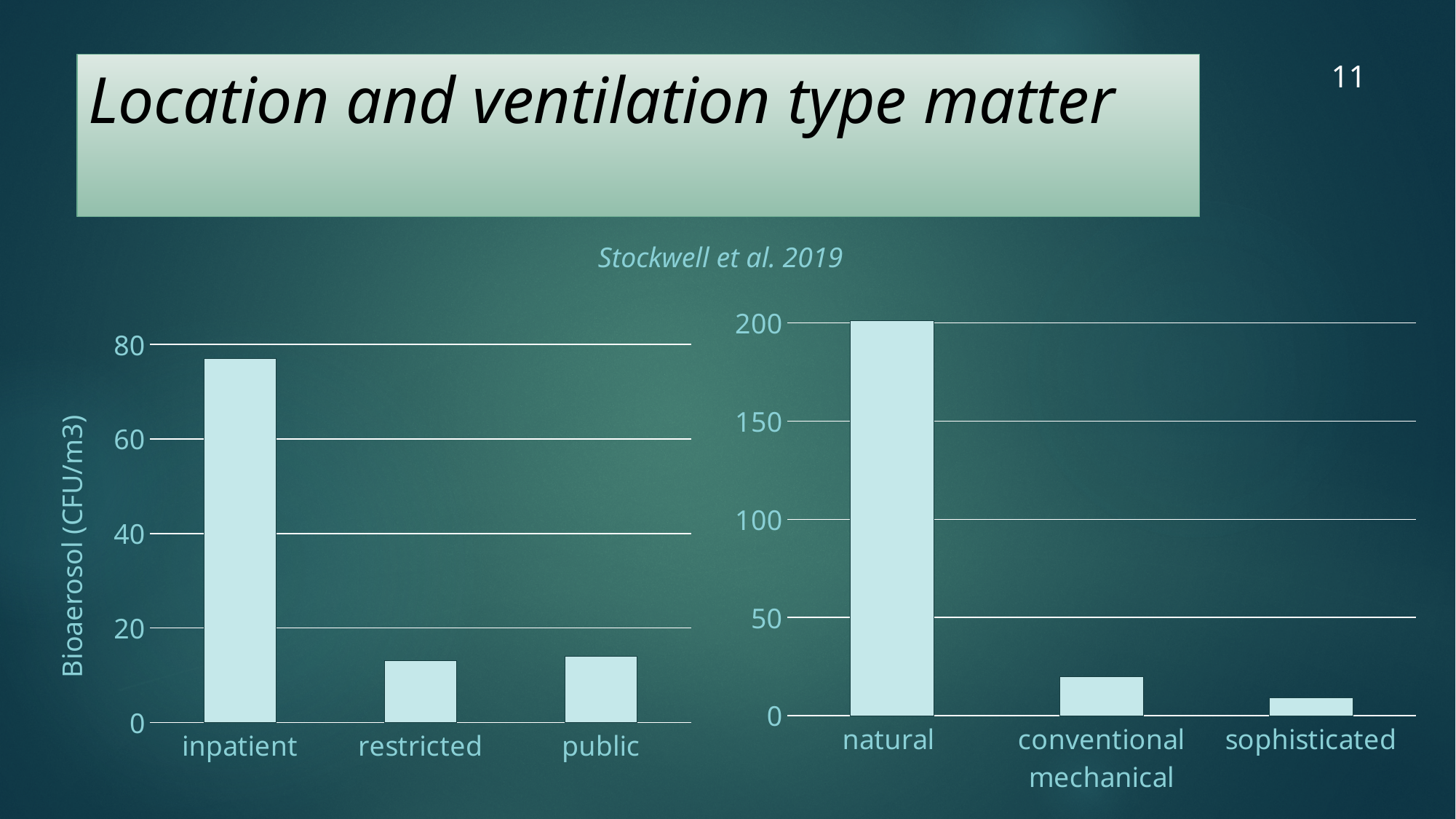
In the right chart, is the value for conventional mechanical greater or less than 50? less In the left chart, is the value for public greater or less than 20? less What type of chart is the left chart on the slide? bar chart How many categories are shown in the right chart? 3 In the right chart, which ventilation type has the highest bioaerosol value? natural In the right chart, which is larger, the value for conventional mechanical or the value for sophisticated? conventional mechanical In the right chart, which ventilation type has the lowest bioaerosol value? sophisticated What is the label on the vertical axis of the left chart? Bioaerosol (CFU/m3) In the left chart, which category has the highest bioaerosol value? inpatient In the left chart, is the value for restricted greater or less than 20? less How many categories are shown in the left chart? 3